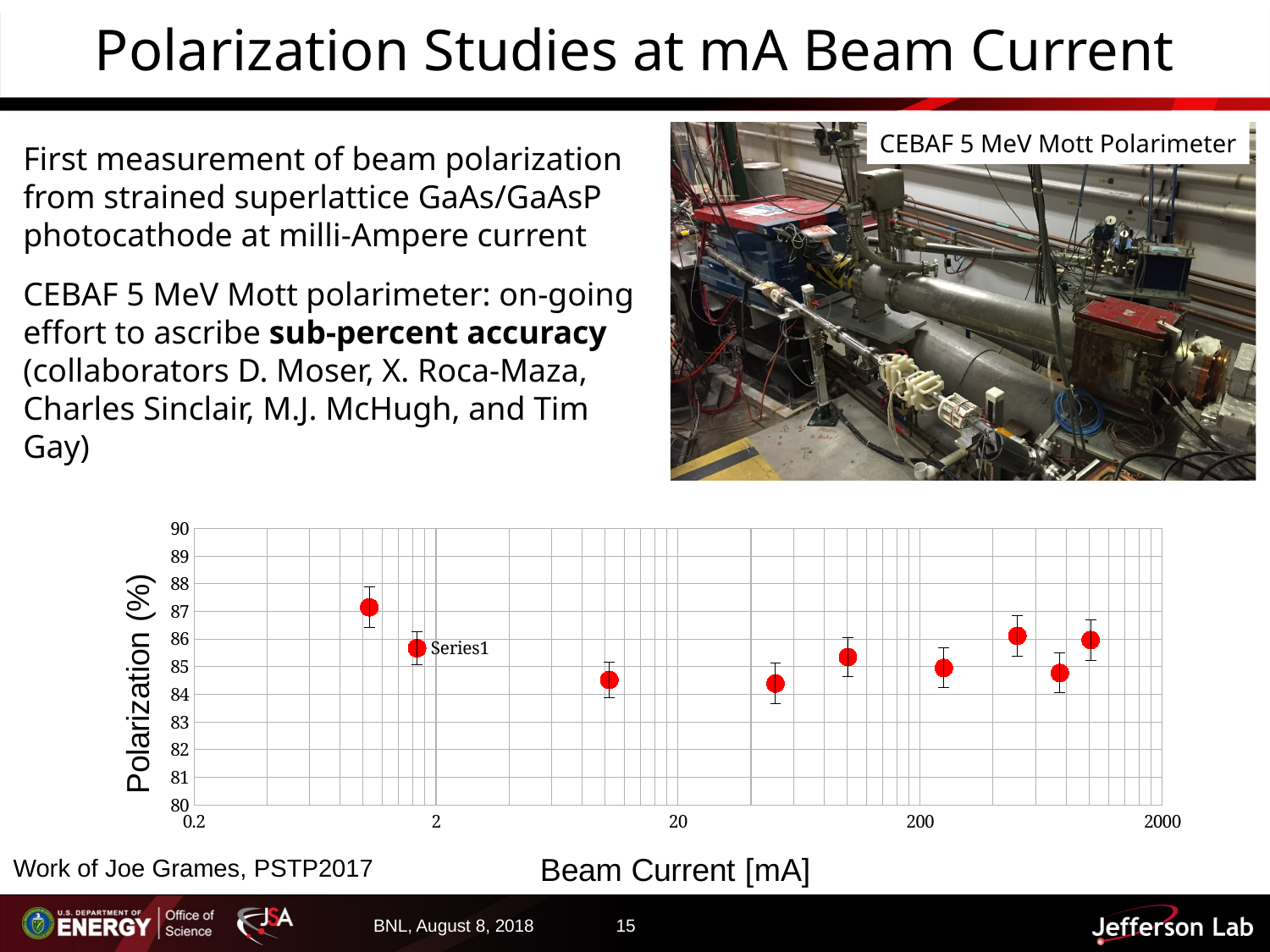
Is the polarization value of the leftmost data point (lowest beam current) greater or less than 86? greater Is the polarization value of the data point near 50 mA greater or less than 86? less What kind of chart is shown at the bottom of the slide? scatter chart What is the label of the x axis of the chart? Beam Current [mA] Are any of the plotted polarization values greater than 88? No Which data point has the highest polarization: the leftmost point or the rightmost point? the leftmost point How many data points are plotted in the chart? 9 What is the label of the y axis of the chart? Polarization (%) What is the highest value shown on the y axis of the chart? 90